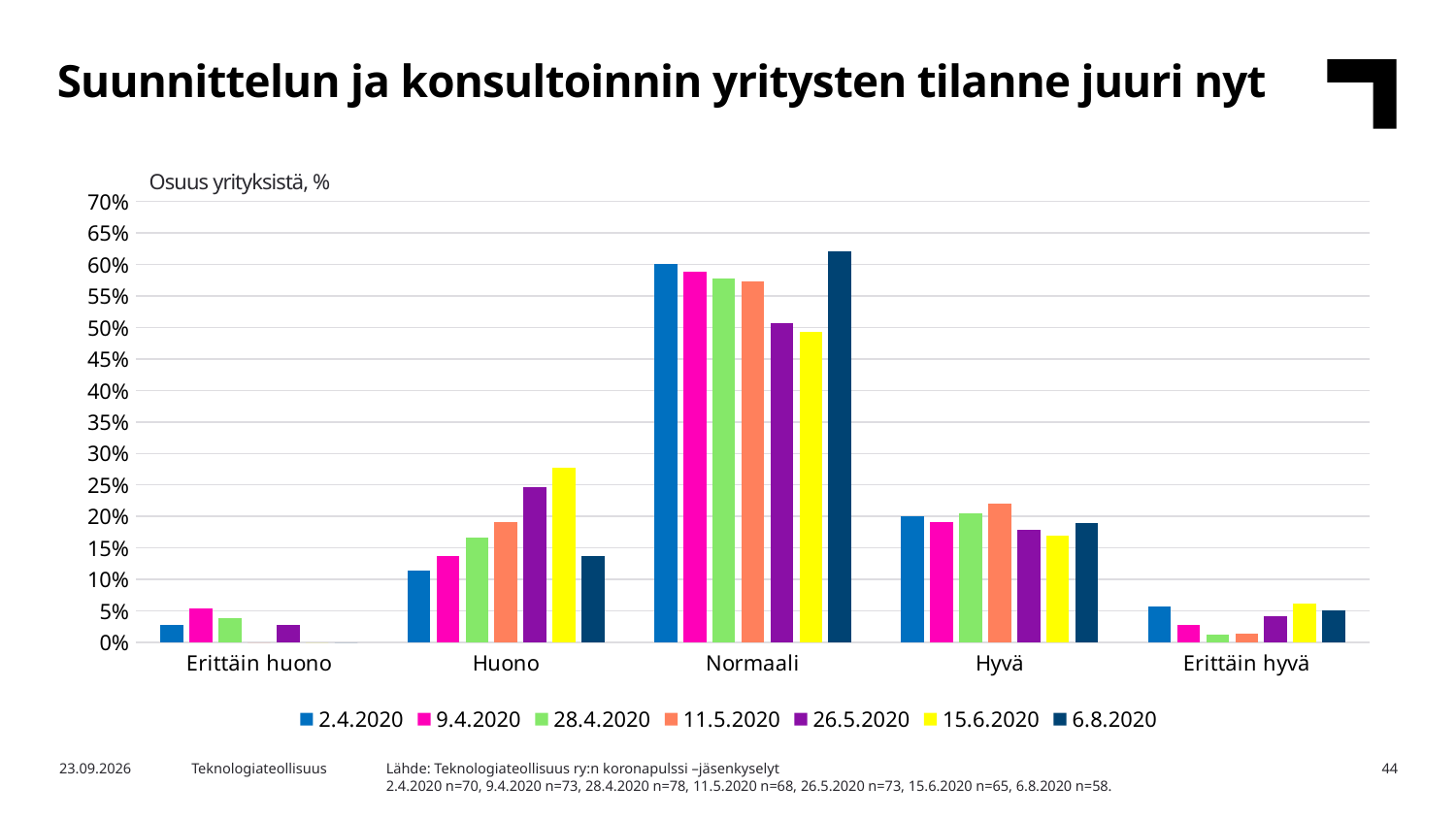
For Huono, which is larger: the 15.6.2020 value or the 6.8.2020 value? 15.6.2020 Is the value for Huono in the 2.4.2020 series greater or less than 15%? less What is the label shown above the y axis of the chart? Osuus yrityksistä, % Is the value for Huono in the 15.6.2020 series greater or less than 25%? greater Is the value for Normaali in the 6.8.2020 series greater or less than 60%? greater Which category has the highest value for the 6.8.2020 series? Normaali Within the Huono category, which series has the highest value? 15.6.2020 What kind of chart is shown on the slide? bar chart How many categories are shown on the x axis of the chart? 5 Do the Huono bars rise or fall across the series from 2.4.2020 to 15.6.2020? rise For Normaali, which is larger: the 2.4.2020 value or the 15.6.2020 value? 2.4.2020 How many series does the legend list? 7